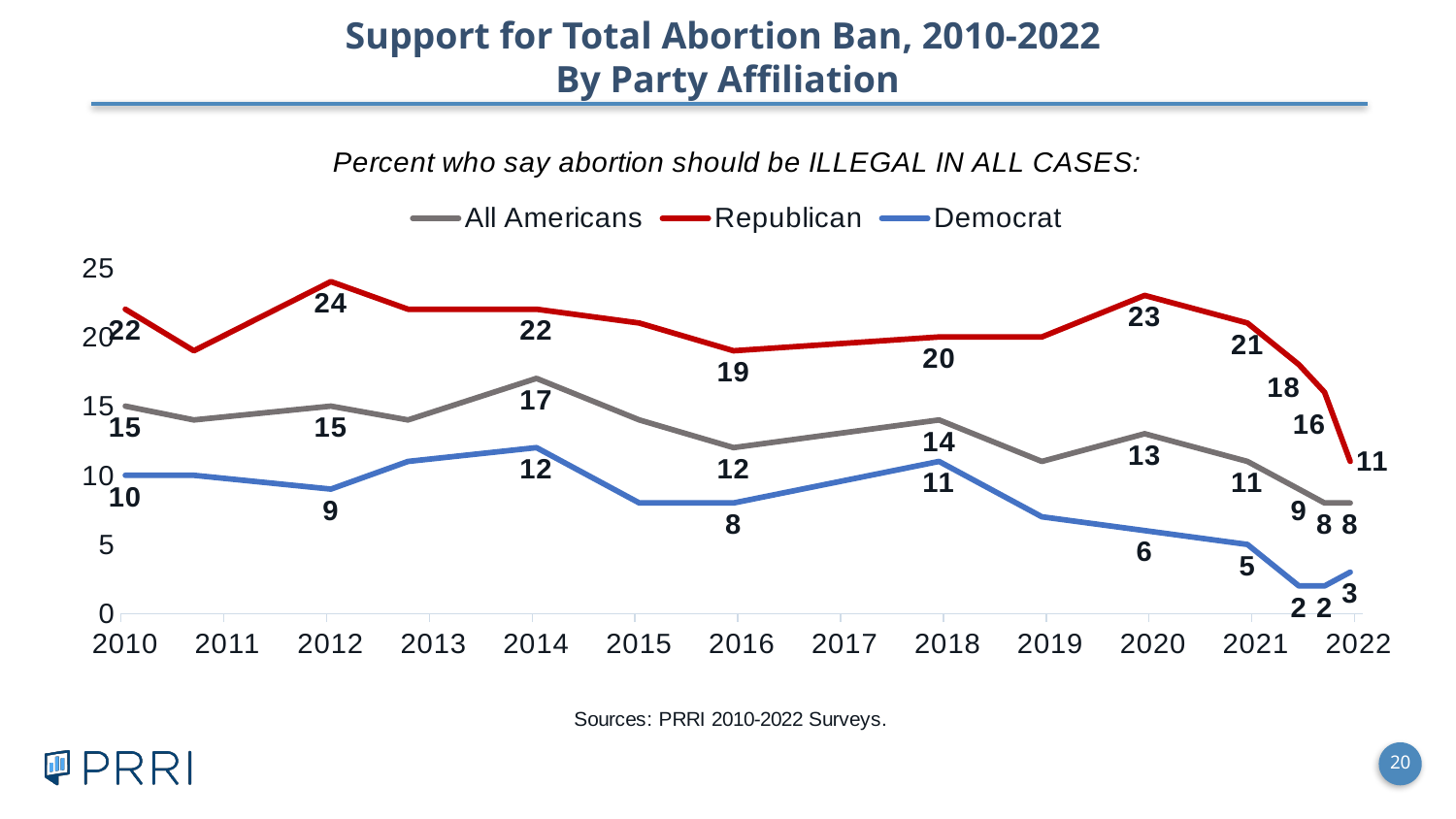
In which year is the Republican line at its highest? 2012 What is the value for All Americans in 2014? 17 What kind of chart is shown on the slide? line chart Which series has the lowest value in 2020? Democrat How many series does the legend list? 3 Which series is drawn in red? Republican For All Americans, which year has the larger value, 2018 or 2020? 2018 What is the value for Republicans in 2022? 11 What percent of Republicans said abortion should be illegal in all cases in 2012? 24 What is the value for Democrats in 2016? 8 What is the difference between the Republican and Democrat values in 2020? 17 Does the Democrat line rise or fall from 2018 to 2022? fall